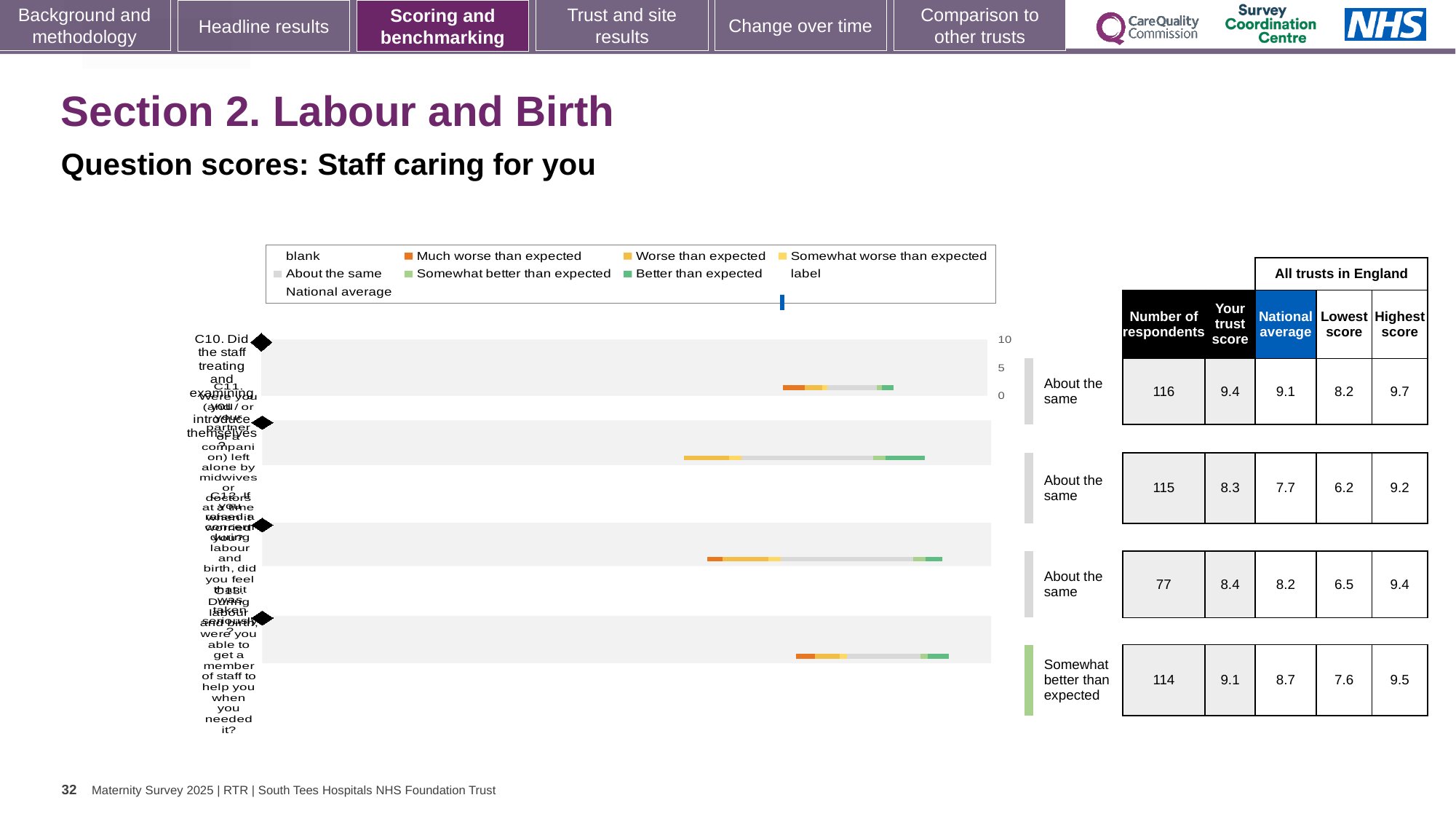
Which is larger for the second row of the table: the trust score or the national average? trust score (8.3) What kind of chart is shown on the slide? bar chart Which row in the table has the fewest respondents? the third row (77) How many entries does the chart legend list? 9 In the table beside the chart, what is the lowest score for the third row? 6.5 What is the difference between the trust score and the national average for the bottom row of the table? 0.4 In the table beside the chart, what is the highest score for the bottom row? 9.5 In the table beside the chart, what is the trust score for the top row? 9.4 In the table beside the chart, what is the number of respondents for the top row? 116 How many question rows (bars) are plotted in the chart? 4 What benchmark category is shown for the bottom row of the chart? Somewhat better than expected In the table beside the chart, what is the national average for the second row? 7.7